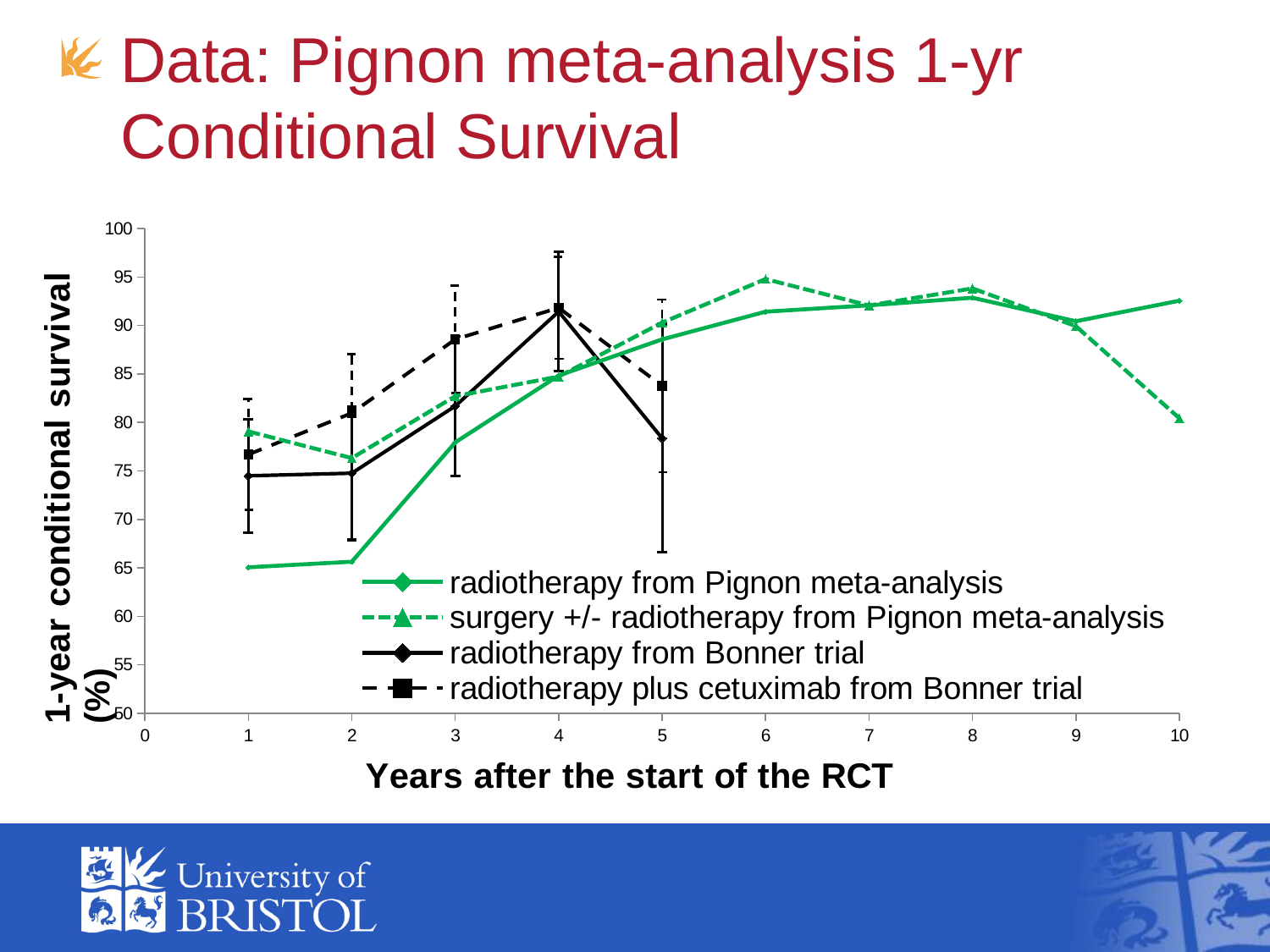
Is the value for 'radiotherapy from Pignon meta-analysis' at year 1 greater or less than 70? less How many data points are plotted for the 'radiotherapy from Bonner trial' series? 5 What is the title of the x axis? Years after the start of the RCT How many series does the legend list? 4 At year 5, which series has the higher value: 'radiotherapy from Bonner trial' or 'radiotherapy plus cetuximab from Bonner trial'? radiotherapy plus cetuximab from Bonner trial Does the 'radiotherapy from Pignon meta-analysis' series rise or fall between year 1 and year 6? rise At which year does the 'radiotherapy from Bonner trial' series reach its highest value? 4 How many data points are plotted for the 'radiotherapy from Pignon meta-analysis' series? 10 Is the value for 'surgery +/- radiotherapy from Pignon meta-analysis' at year 6 greater or less than 90? greater Is the value for 'radiotherapy from Bonner trial' at year 2 greater or less than 80? less At year 1, which series has the higher value: 'radiotherapy from Pignon meta-analysis' or 'surgery +/- radiotherapy from Pignon meta-analysis'? surgery +/- radiotherapy from Pignon meta-analysis What kind of chart is shown on the slide? line chart